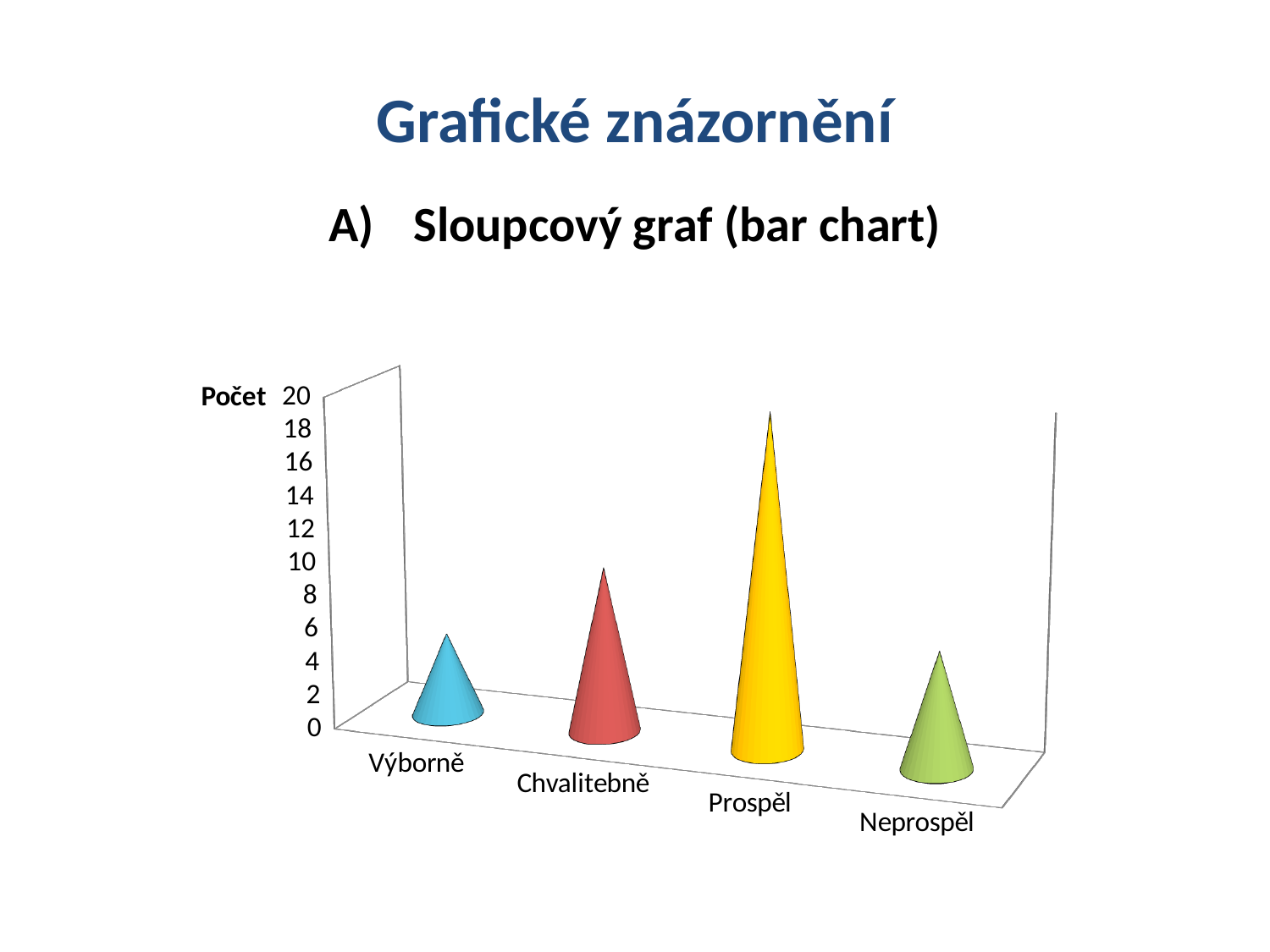
Which is larger, the value for Chvalitebně or the value for Výborně? Chvalitebně Is the value for Chvalitebně greater or less than 6? greater Which category has the highest value in the chart? Prospěl Which is larger, the value for Prospěl or the value for Chvalitebně? Prospěl What is the label of the vertical axis of the chart? Počet What kind of chart is shown on the slide? bar chart How many categories are shown on the x axis of the chart? 4 Is the value for Neprospěl greater or less than 10? less Is the value for Prospěl greater or less than 14? greater What is the highest tick value shown on the vertical axis? 20